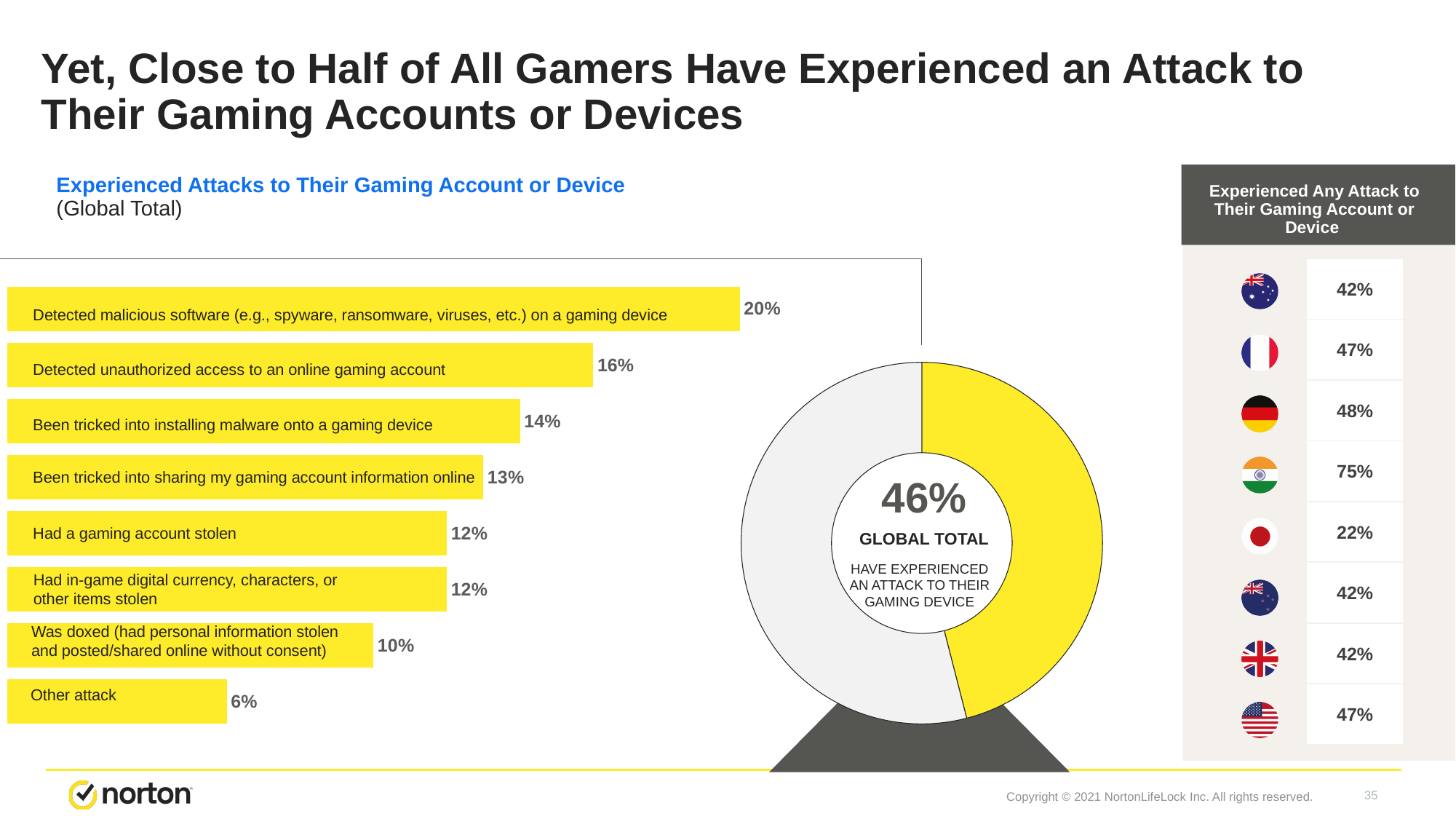
In the bar chart 'Experienced Attacks to Their Gaming Account or Device (Global Total)', what percentage detected unauthorized access to an online gaming account? 16% In the bar chart 'Experienced Attacks to Their Gaming Account or Device (Global Total)', what percentage detected malicious software on a gaming device? 20% In the donut chart in the center of the slide, what is the global total percentage of gamers who have experienced an attack to their gaming device? 46% In the bar chart 'Experienced Attacks to Their Gaming Account or Device (Global Total)', what is the difference between 'Detected malicious software on a gaming device' and 'Was doxed'? 10% In the bar chart 'Experienced Attacks to Their Gaming Account or Device (Global Total)', which category has the highest value? Detected malicious software (e.g., spyware, ransomware, viruses, etc.) on a gaming device In the bar chart 'Experienced Attacks to Their Gaming Account or Device (Global Total)', what is the value for 'Other attack'? 6% In the bar chart 'Experienced Attacks to Their Gaming Account or Device (Global Total)', what is the value for 'Had a gaming account stolen'? 12% What kind of chart is the chart on the left of the slide, 'Experienced Attacks to Their Gaming Account or Device (Global Total)'? Bar chart In the bar chart 'Experienced Attacks to Their Gaming Account or Device (Global Total)', which category has the lowest value? Other attack In the bar chart 'Experienced Attacks to Their Gaming Account or Device (Global Total)', which is larger: 'Been tricked into installing malware onto a gaming device' or 'Been tricked into sharing my gaming account information online'? Been tricked into installing malware onto a gaming device What kind of chart is the chart in the center of the slide showing the global total? Donut chart How many categories are shown in the bar chart 'Experienced Attacks to Their Gaming Account or Device (Global Total)'? 8